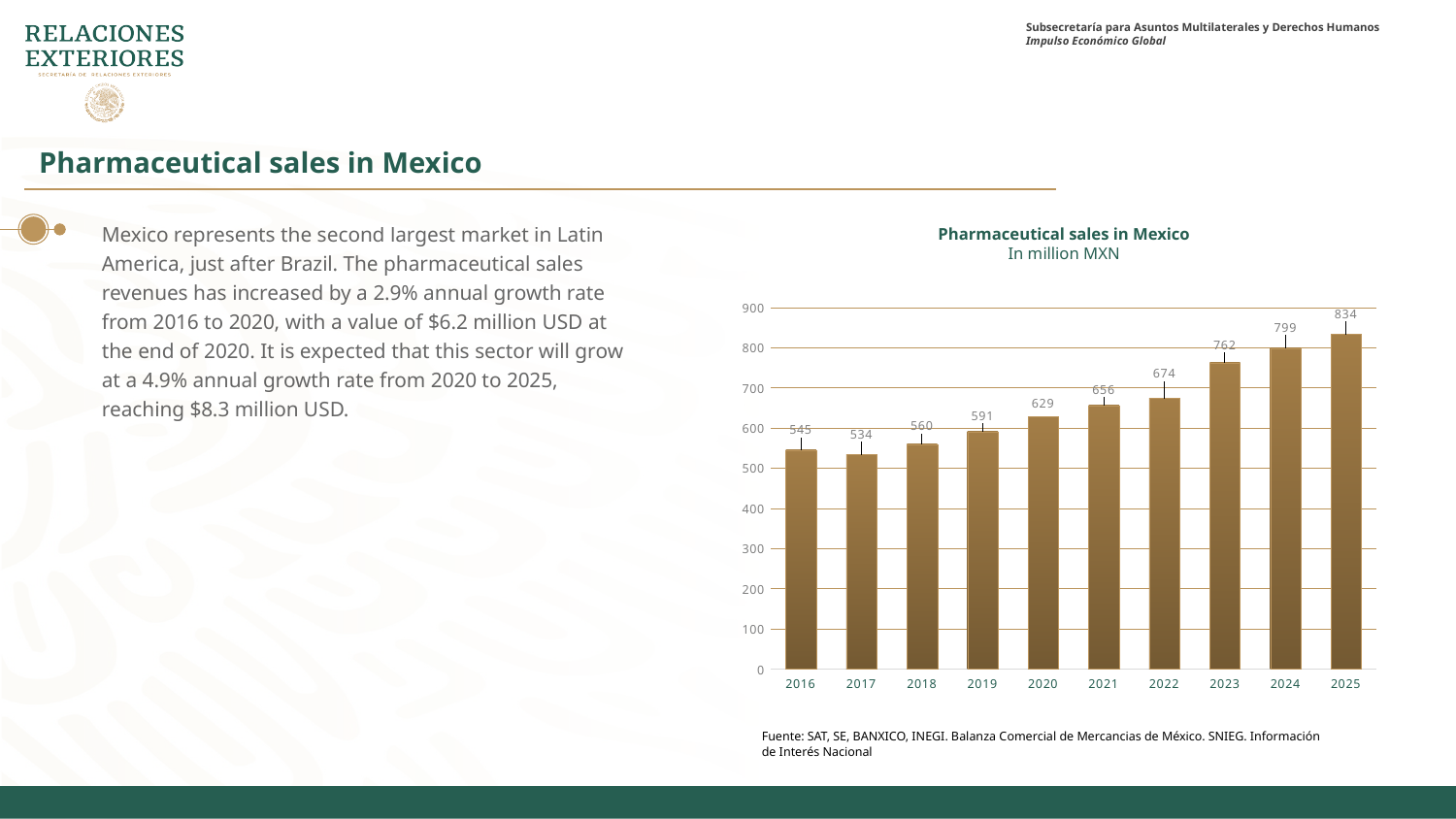
Which year has the highest value? 2025 Is the value for 2023 greater or less than 700? greater What is the value for 2020? 629 Which year has the lowest value? 2017 What is the value for 2016? 545 What is the difference between the values for 2021 and 2020? 27 What is the difference between the values for 2025 and 2016? 289 What kind of chart is shown? bar chart Do the values generally rise or fall from 2017 to 2025? rise What is the value for 2025? 834 Which is larger, the value for 2018 or the value for 2019? 2019 How many years are shown on the x axis? 10